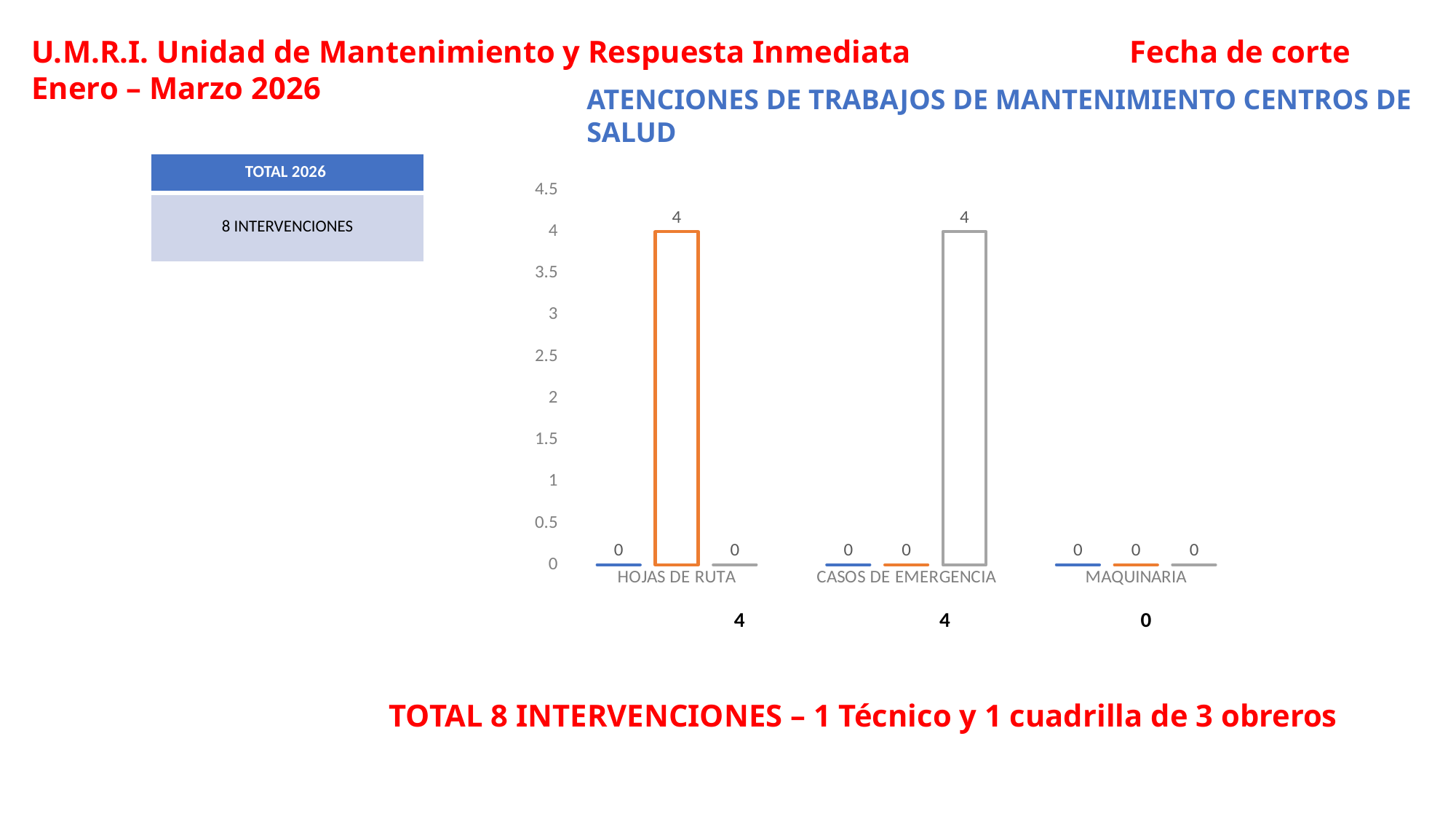
What is the value of the gray bar for CASOS DE EMERGENCIA? 4 What type of chart is shown on the slide? bar chart What is the value of the orange bar for CASOS DE EMERGENCIA? 0 What is the value of the orange bar for HOJAS DE RUTA? 4 What is the value of the gray bar for MAQUINARIA? 0 How many categories are shown on the x axis of the chart? 3 Which category has all three of its bars at 0? MAQUINARIA What is the highest value shown on the chart's y axis? 4.5 Which is larger: the gray bar for CASOS DE EMERGENCIA or the gray bar for HOJAS DE RUTA? gray bar for CASOS DE EMERGENCIA What is the difference between the orange bar for HOJAS DE RUTA and the orange bar for CASOS DE EMERGENCIA? 4 What is the value of the blue bar for HOJAS DE RUTA? 0 What is the title of the chart? ATENCIONES DE TRABAJOS DE MANTENIMIENTO CENTROS DE SALUD